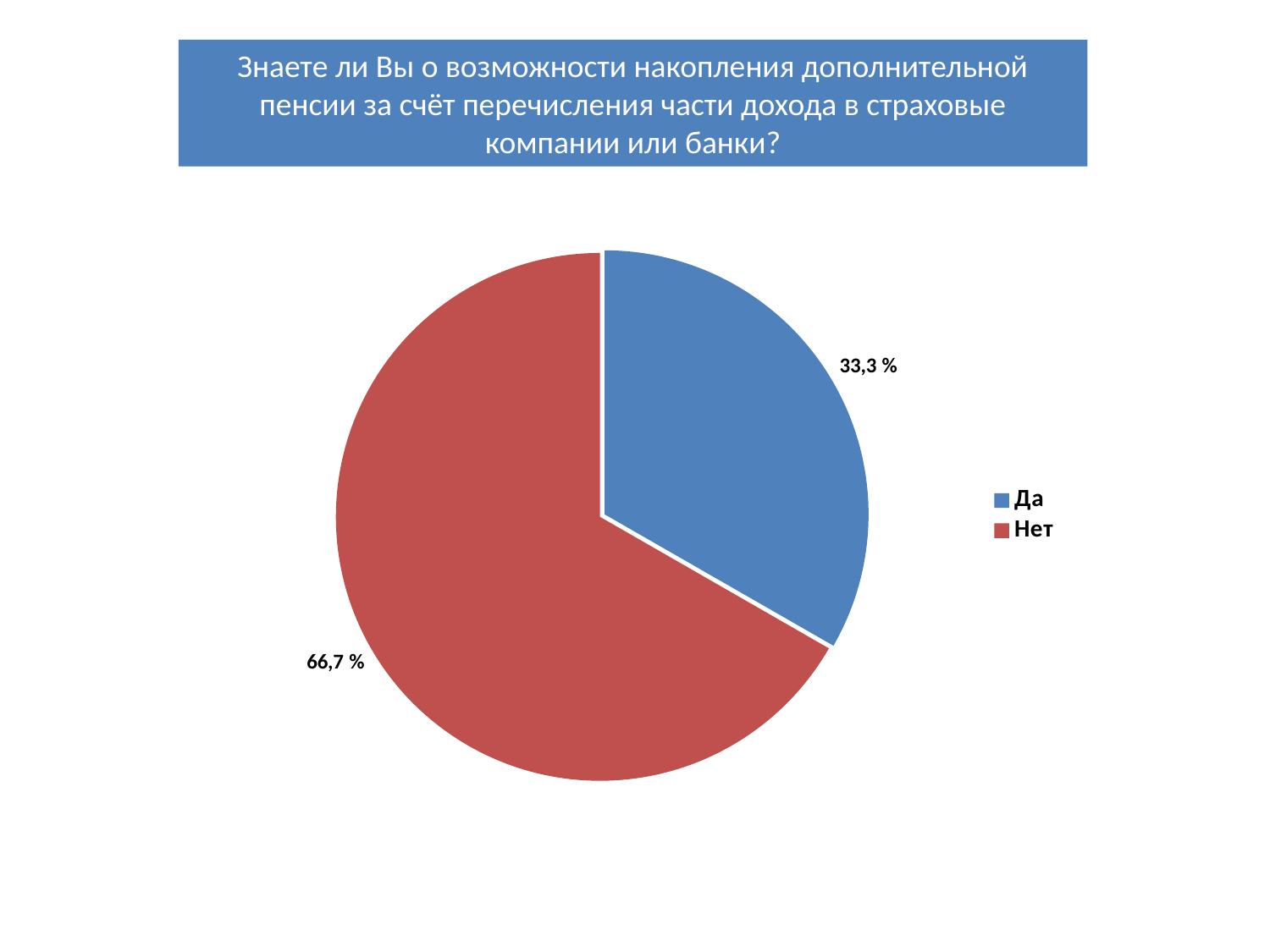
How many slices does the pie chart have? 2 What kind of chart is shown on the slide? Pie chart What share of the pie does the "Да" slice represent? 33,3 % What share of the pie does the "Нет" slice represent? 66,7 % What colour is the "Да" slice? Blue What is the difference in percentage points between the "Нет" and "Да" slices? 33,4 % Which category has the largest slice of the pie? Нет What colour is the "Нет" slice? Red How many entries does the legend list? 2 Which slice is larger, "Да" or "Нет"? Нет Which category has the smallest slice of the pie? Да